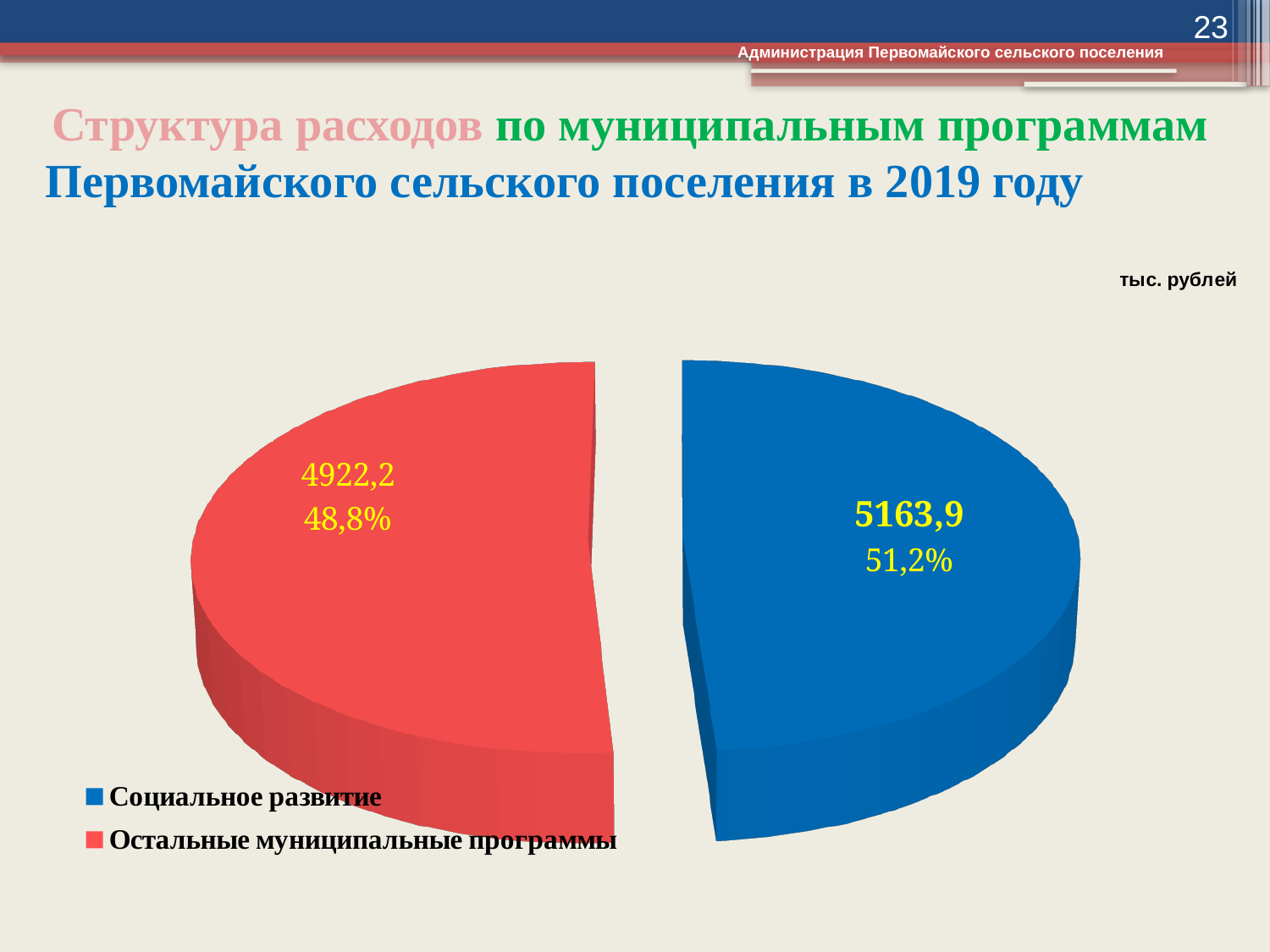
What is the value for Остальные муниципальные программы? 4922,2 What colour is the slice for Остальные муниципальные программы? Red Which category has the largest slice of the pie? Социальное развитие What kind of chart is shown on the slide? Pie chart What share of the pie does Социальное развитие take? 51,2% What is the value for Социальное развитие? 5163,9 How many slices does the pie chart have? 2 In what units are the values on the chart given? тыс. рублей Which is larger: Социальное развитие or Остальные муниципальные программы? Социальное развитие What is the difference between the values for Социальное развитие and Остальные муниципальные программы? 241,7 Which category has the smallest slice of the pie? Остальные муниципальные программы What share of the pie does Остальные муниципальные программы take? 48,8%